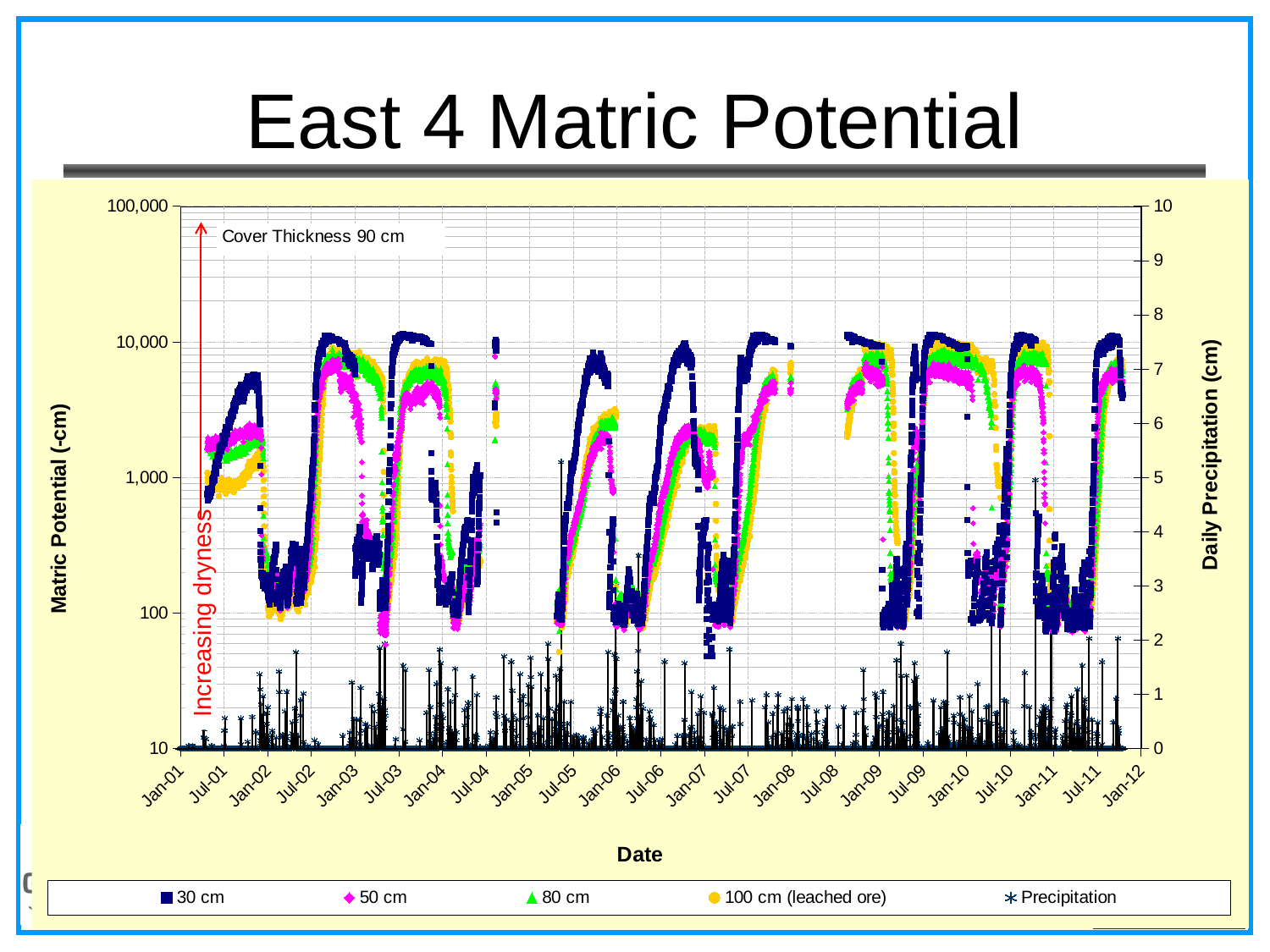
What is the last date label on the x axis? Jan-12 Which legend series is described as leached ore? 100 cm (leached ore) What is the label of the left vertical axis? Matric Potential (-cm) Is the 30 cm matric potential around Jan-02 greater or less than 1,000? less What is the first date label on the x axis? Jan-01 What kind of chart is this? scatter chart Is the 30 cm matric potential around Jan-03 greater or less than 1,000? greater What is the lowest value shown on the left-hand matric potential axis? 10 What is the highest value shown on the right-hand precipitation axis? 10 What is the title of the chart? East 4 Matric Potential How many series does the legend list? 5